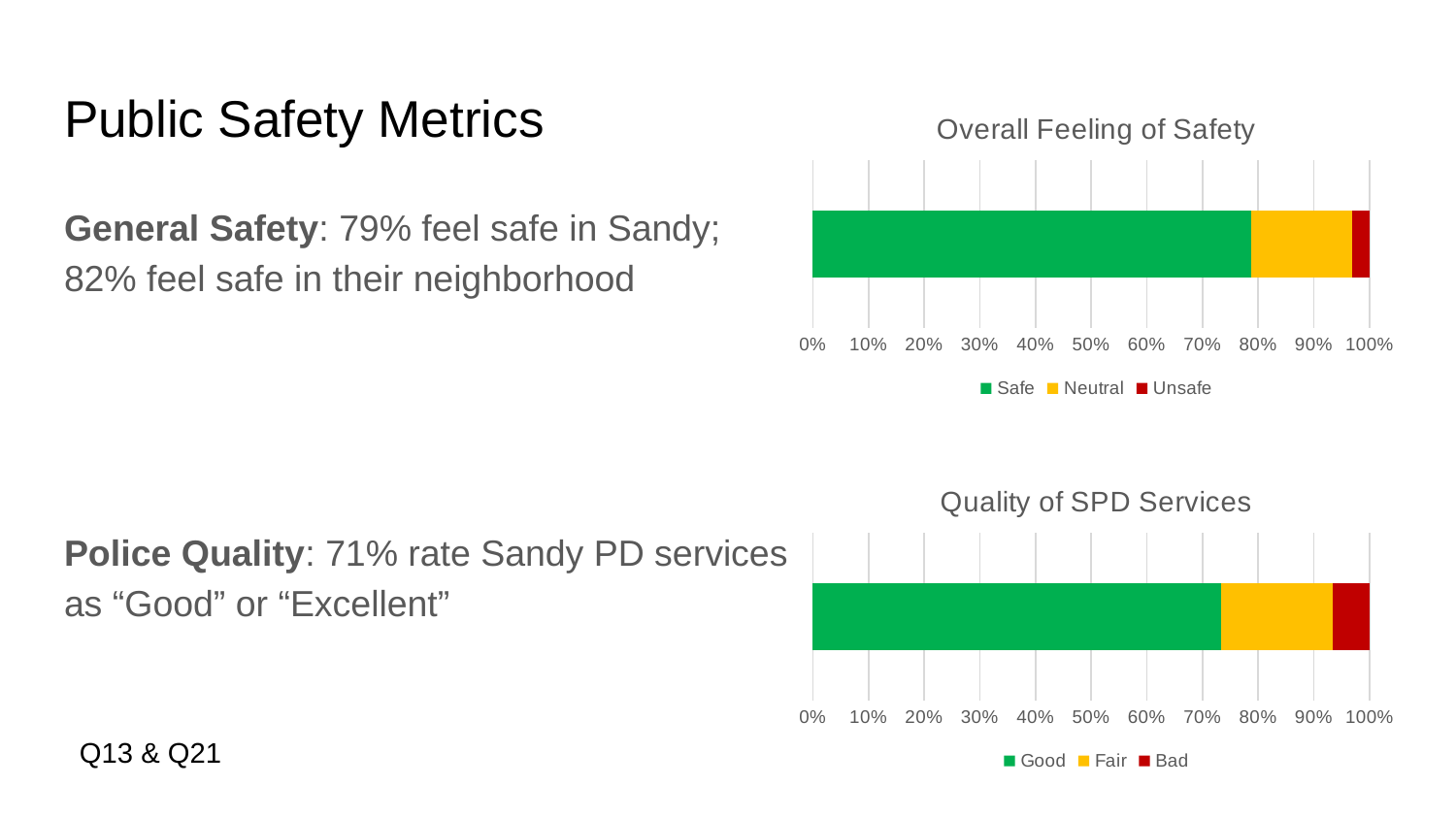
In the "Quality of SPD Services" chart, is the Bad share greater or less than 10%? less In the "Overall Feeling of Safety" chart, which is larger, the Safe segment or the Neutral segment? Safe In the "Overall Feeling of Safety" chart, which segment is the largest? Safe How many series does the legend of the "Overall Feeling of Safety" chart list? 3 In the "Overall Feeling of Safety" chart, is the Unsafe share greater or less than 10%? less What colour represents the "Fair" series in the "Quality of SPD Services" chart? Yellow In the "Overall Feeling of Safety" chart, is the Safe share greater or less than 70%? greater What kind of chart is the "Overall Feeling of Safety" chart? Stacked bar chart In the "Quality of SPD Services" chart, which segment is the largest? Good How many series does the legend of the "Quality of SPD Services" chart list? 3 In the "Overall Feeling of Safety" chart, which segment is the smallest? Unsafe